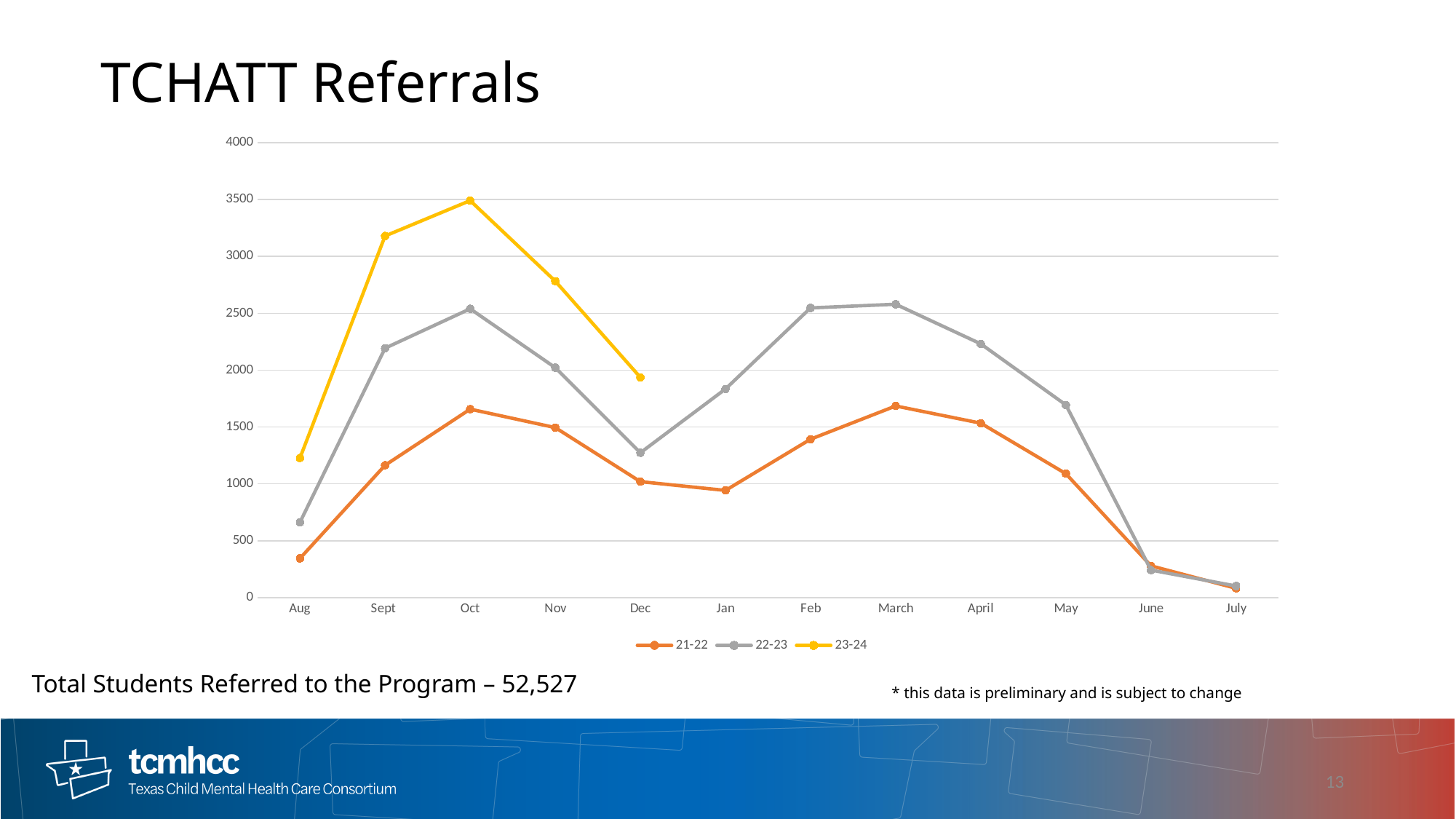
Which series is drawn in yellow? 23-24 What kind of chart is shown on the slide? line chart How many series does the legend list? 3 In which month does the 23-24 series reach its highest value? Oct How many months are shown along the x axis? 12 Is the value for 22-23 in Aug greater or less than 1000? less Which series has the higher value in Oct, 23-24 or 22-23? 23-24 Is the value for 23-24 in Oct greater or less than 3000? greater In which month does the 22-23 series reach its lowest value? July Does the 23-24 series rise or fall from Oct to Dec? fall What is the title of the chart? TCHATT Referrals Is the value for 21-22 in Aug greater or less than 500? less